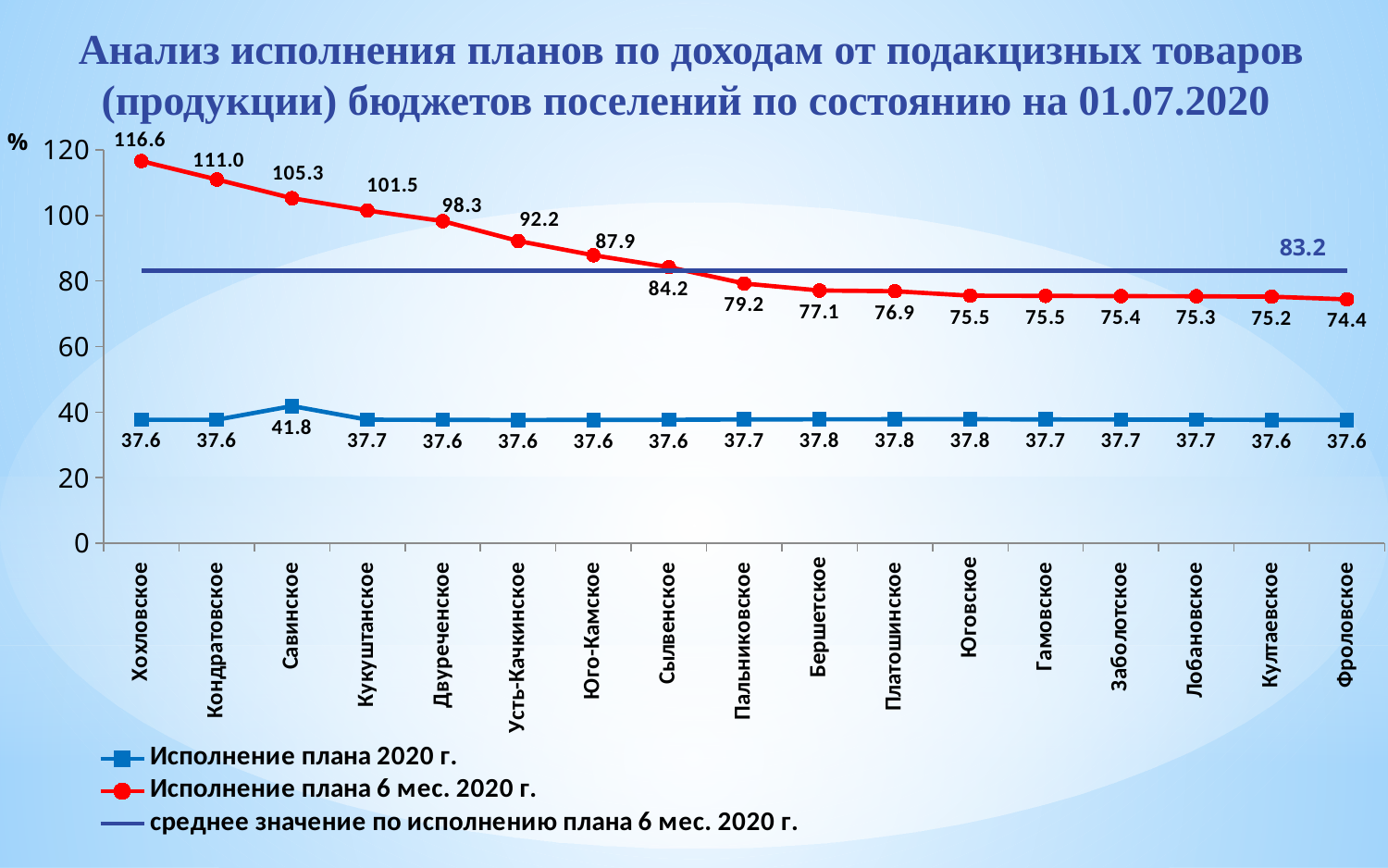
What type of chart is shown on the slide? line chart What is the value of 'Исполнение плана 6 мес. 2020 г.' for Сылвенское? 84.2 How many series does the legend list? 3 What is the value of the line 'среднее значение по исполнению плана 6 мес. 2020 г.'? 83.2 Which settlement has the highest value for 'Исполнение плана 2020 г.'? Савинское Does the 'Исполнение плана 6 мес. 2020 г.' series rise or fall from left to right along the x axis? fall What is the difference between the 'Исполнение плана 6 мес. 2020 г.' values for Хохловское and Фроловское? 42.2 What is the value of 'Исполнение плана 2020 г.' for Савинское? 41.8 What is the value of 'Исполнение плана 6 мес. 2020 г.' for Хохловское? 116.6 How many settlements (categories) are plotted along the x axis? 17 Which is larger: the 'Исполнение плана 6 мес. 2020 г.' value for Кукуштанское or for Усть-Качкинское? Кукуштанское Which settlement has the lowest value for 'Исполнение плана 6 мес. 2020 г.'? Фроловское